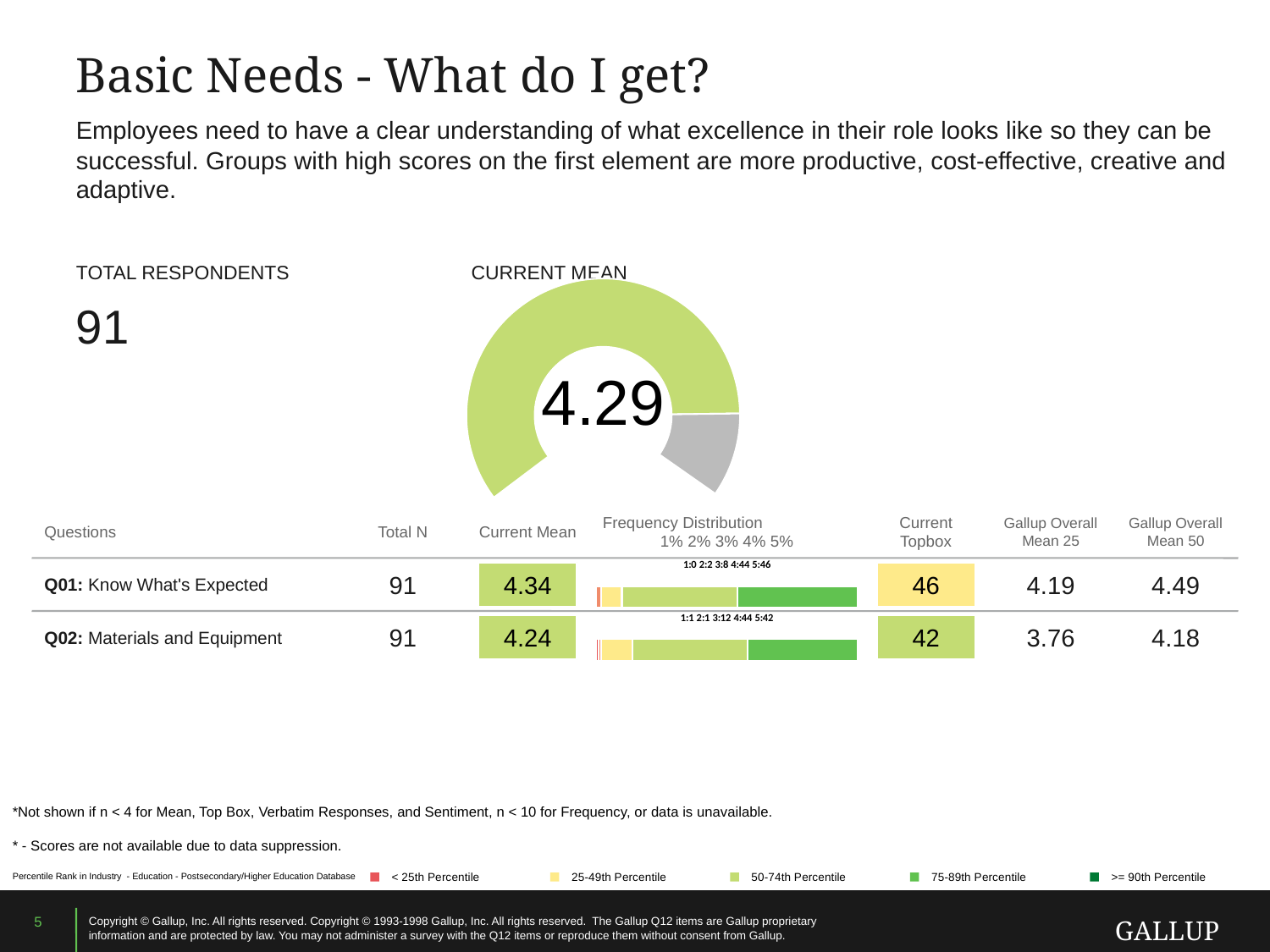
How many percentile categories does the legend at the bottom of the slide list? 5 In the Frequency Distribution bar for Q01: Know What's Expected, what percentage of respondents answered 5? 46 What is the total number of respondents shown on the slide? 91 How many questions are shown with Frequency Distribution bars in the table? 2 In the Frequency Distribution bar for Q02: Materials and Equipment, what percentage of respondents answered 3? 12 What is the Current Topbox value for Q02: Materials and Equipment? 42 What is the difference between the Current Mean of Q01: Know What's Expected and Q02: Materials and Equipment? 0.10 What value does the Current Mean gauge chart display? 4.29 Which question has the higher Current Mean, Q01: Know What's Expected or Q02: Materials and Equipment? Q01: Know What's Expected In the Frequency Distribution bar for Q01: Know What's Expected, what percentage of respondents answered 4? 44 What is the difference between the Gallup Overall Mean 50 and Gallup Overall Mean 25 for Q02: Materials and Equipment? 0.42 What kind of chart is used to show the Current Mean of 4.29? Gauge chart